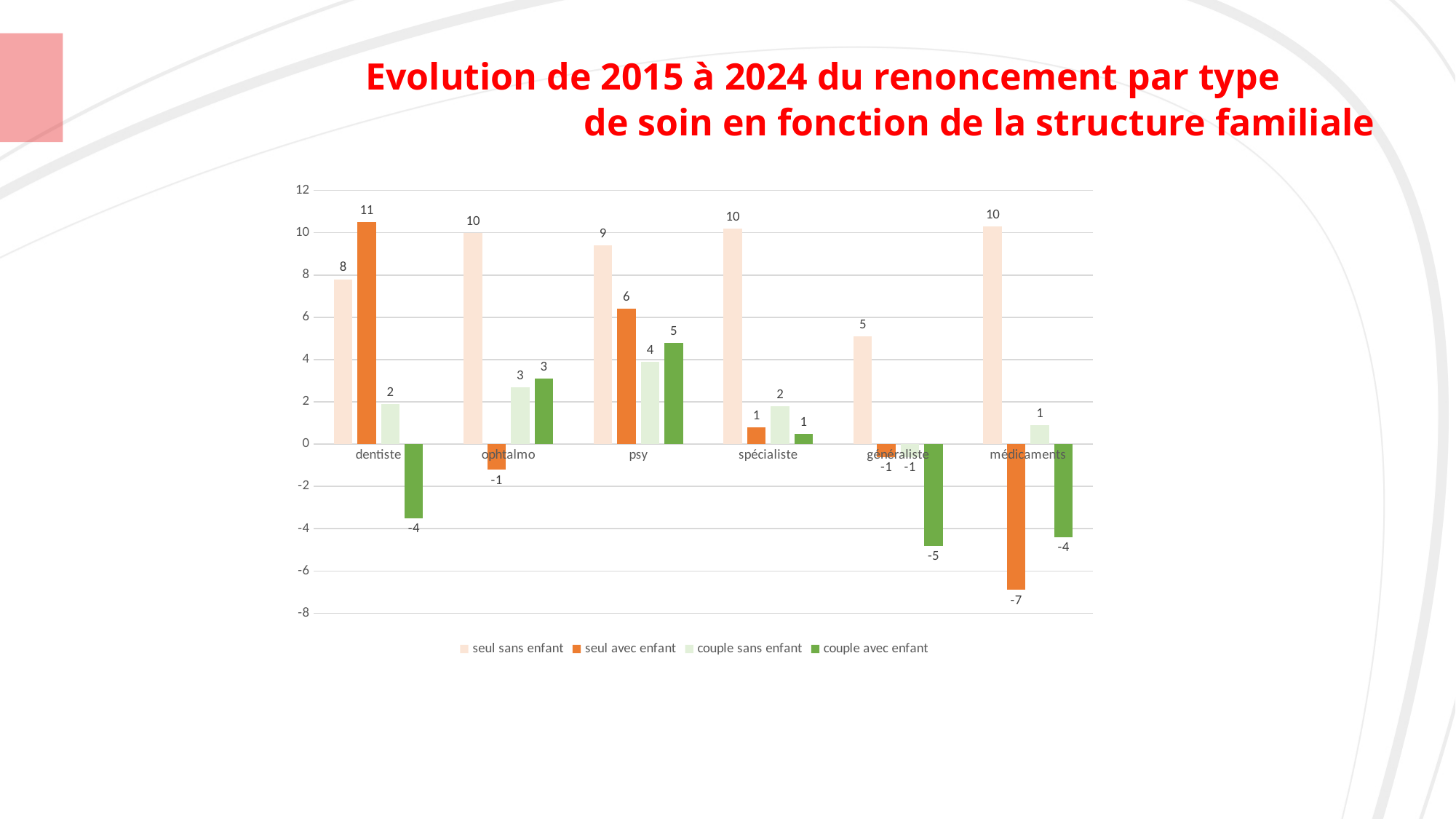
What kind of chart is shown on the slide? bar chart What is the value for 'couple avec enfant' in the généraliste category? -5 How many types of care (categories) are shown on the x axis? 6 In the dentiste category, what is the difference between the 'seul avec enfant' value and the 'seul sans enfant' value? 3 What is the title of the chart on the slide? Evolution de 2015 à 2024 du renoncement par type de soin en fonction de la structure familiale In which category is the 'seul avec enfant' value highest? dentiste What is the value for 'seul avec enfant' in the dentiste category? 11 Which is larger: the 'seul avec enfant' value for psy or for spécialiste? psy Is the 'seul sans enfant' value for dentiste greater or less than 6? greater How many series does the legend list? 4 In which category is the 'couple avec enfant' value lowest? généraliste What is the value for 'seul avec enfant' in the médicaments category? -7